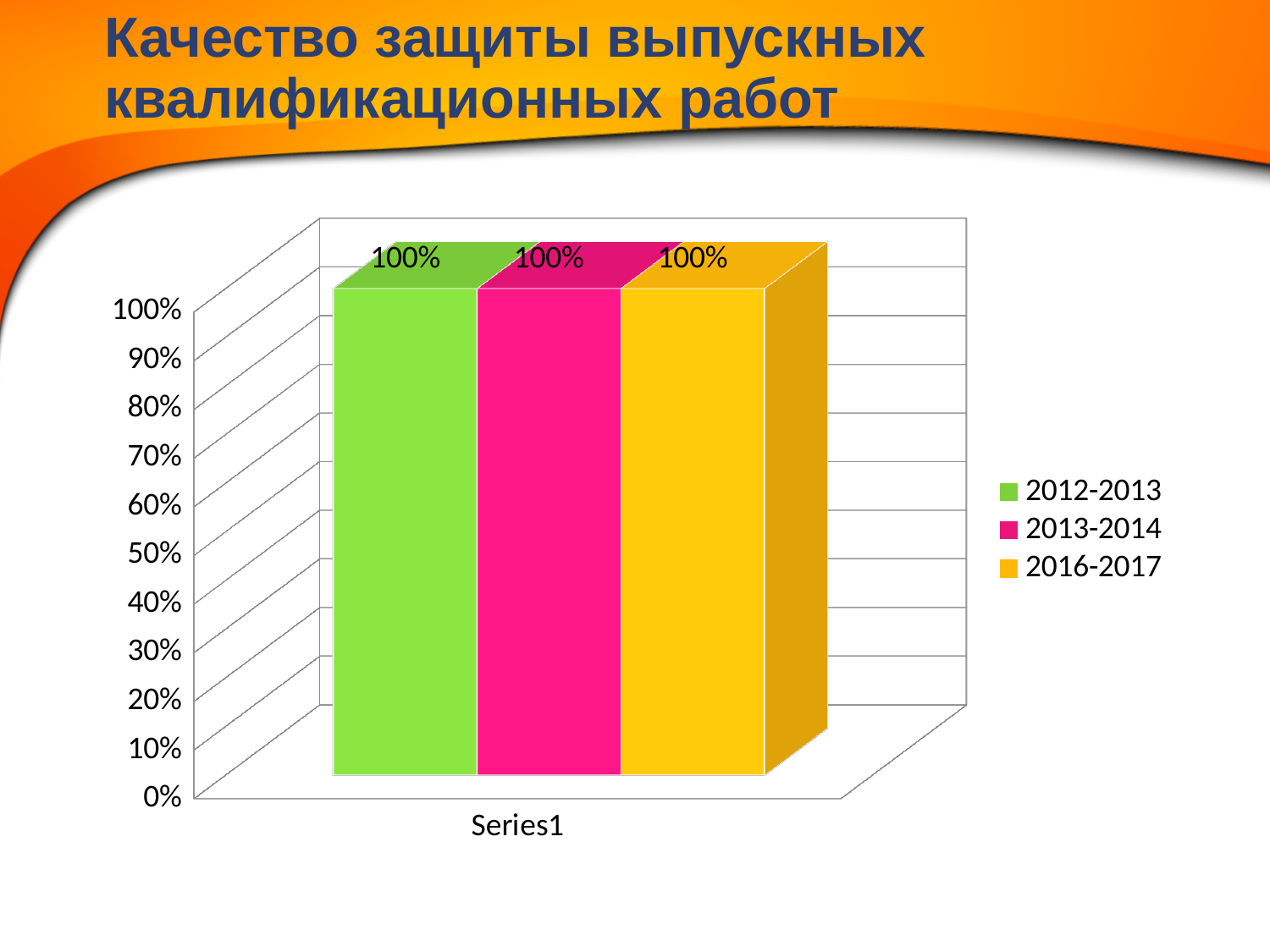
How many bars are plotted in the chart? 3 What is the value for 2013-2014? 100% What colour is the bar for 2016-2017? yellow Is the value for 2013-2014 greater or less than 50%? greater What kind of chart is shown on the slide? bar chart What is the value for 2012-2013? 100% What is the difference between the values for 2012-2013 and 2016-2017? 0% What is the title of the slide above the chart? Качество защиты выпускных квалификационных работ How many series does the legend list? 3 Do the values differ between the three series, or are they all the same? all the same What is the value for 2016-2017? 100%